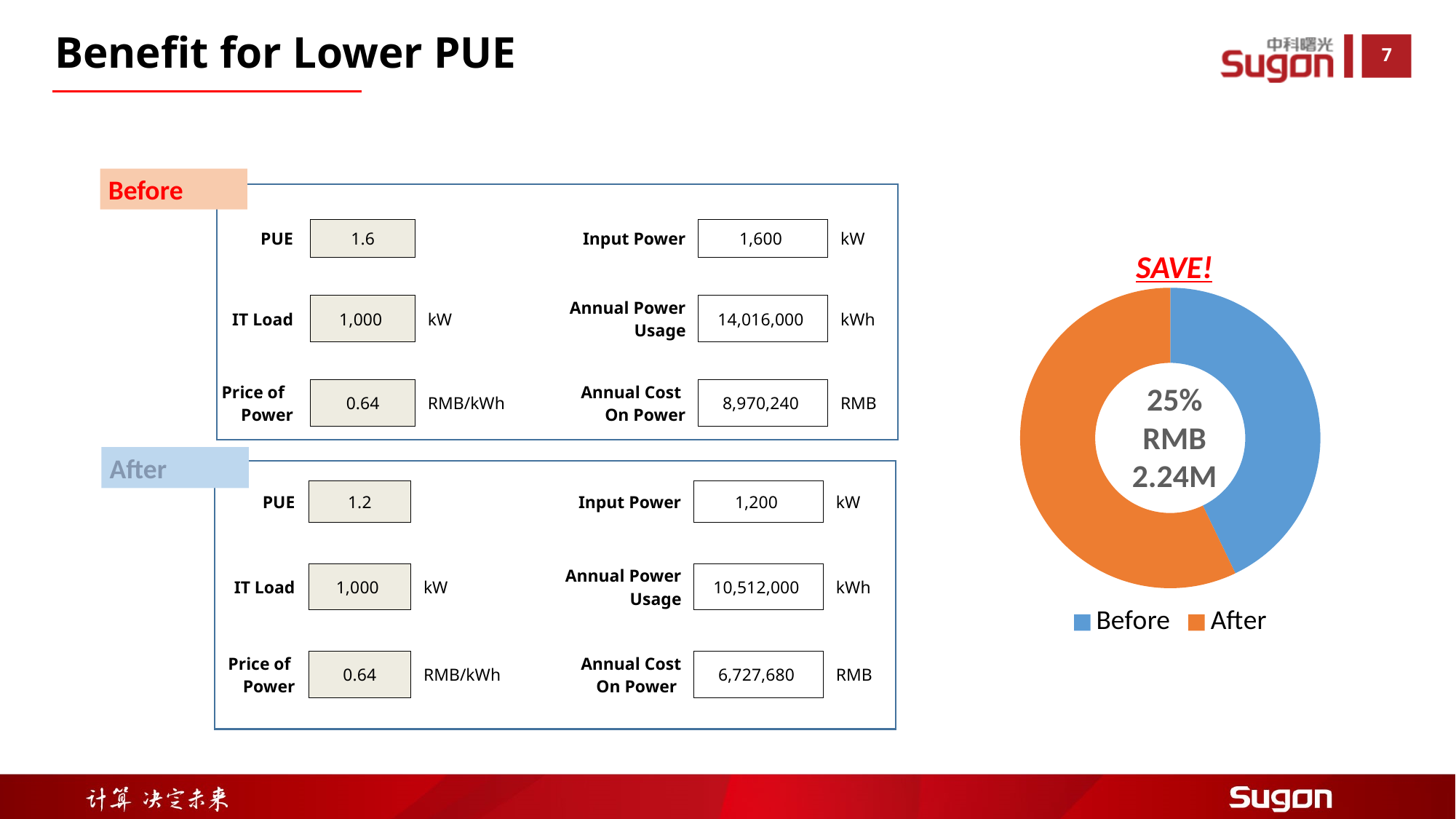
How many entries does the legend of the doughnut chart list? 2 What text is written above the doughnut chart? SAVE! What colour is the Before slice in the doughnut chart? blue Which slice of the doughnut chart is larger, Before or After? After What kind of chart is shown on the slide? doughnut chart Which category has the smallest slice in the doughnut chart? Before Which category has the largest slice in the doughnut chart? After How many slices does the doughnut chart have? 2